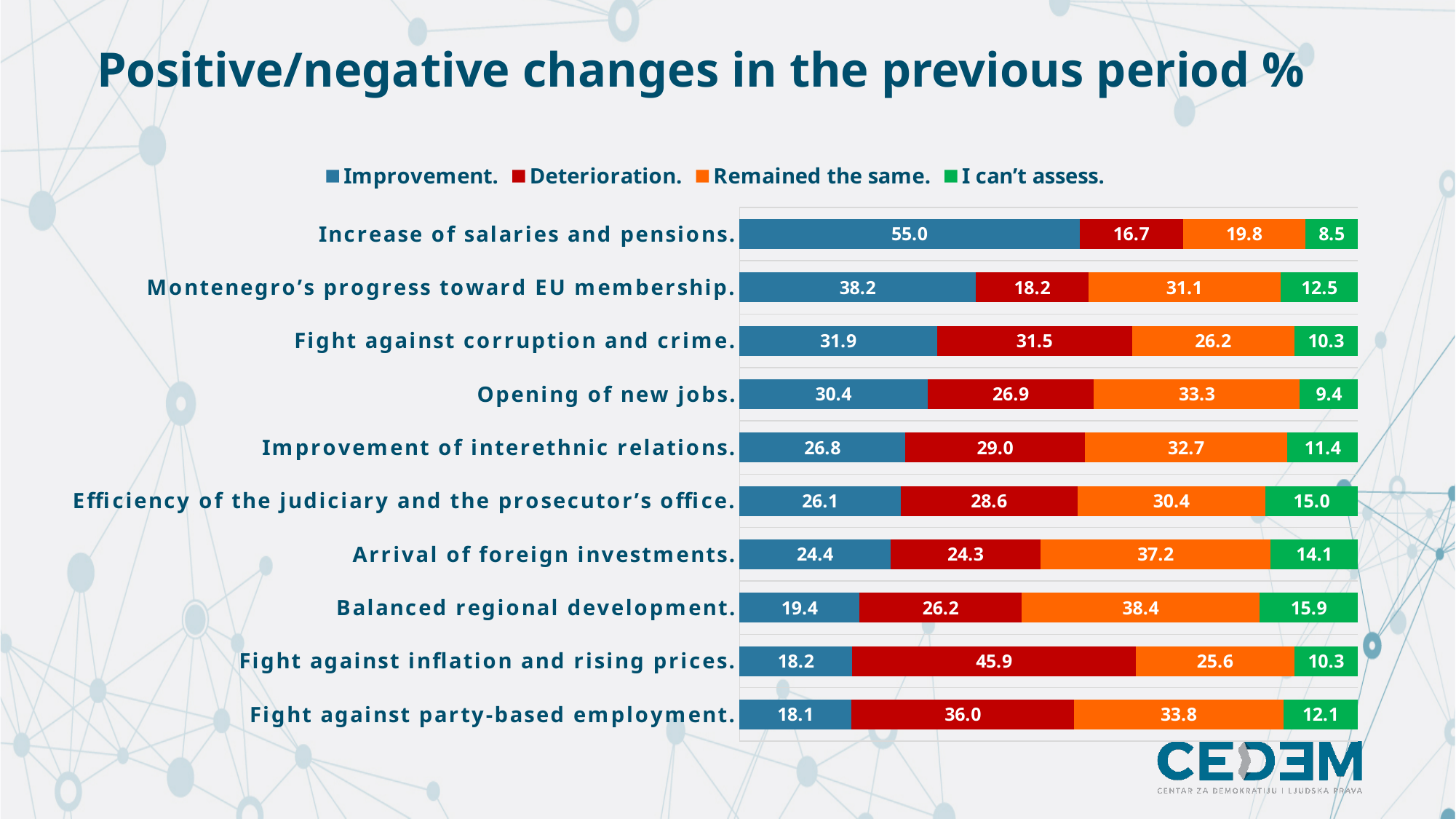
How many series does the legend list? 4 What kind of chart is shown on the slide? Stacked bar chart Which category has the highest Improvement value? Increase of salaries and pensions. What is the difference between the Improvement values for Increase of salaries and pensions and Montenegro's progress toward EU membership? 16.8 Which category has the lowest Improvement value? Fight against party-based employment. What is the Improvement value for Increase of salaries and pensions? 55.0 What is the Remained the same value for Balanced regional development? 38.4 Which category has the highest Deterioration value? Fight against inflation and rising prices. What is the I can't assess value for Efficiency of the judiciary and the prosecutor's office? 15.0 What is the Deterioration value for Fight against inflation and rising prices? 45.9 How many categories are shown in the chart? 10 Which is larger: the Deterioration value for Fight against corruption and crime or for Opening of new jobs? Fight against corruption and crime.